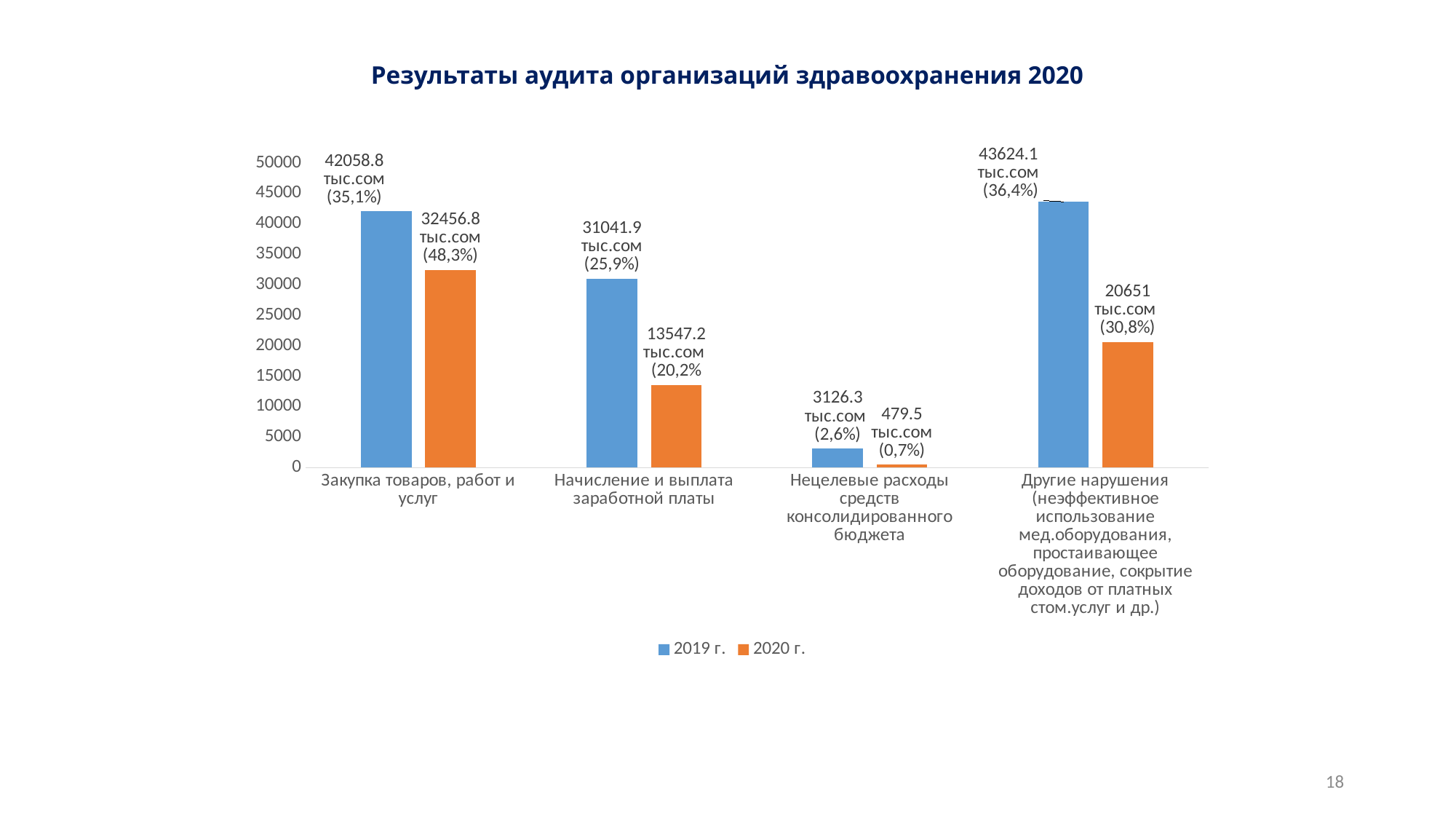
What is the 2019 г. value for Закупка товаров, работ и услуг? 42058.8 тыс.сом What type of chart is shown on the slide? bar chart What is the title of the chart? Результаты аудита организаций здравоохранения 2020 What is the difference between the 2019 г. and 2020 г. values for Другие нарушения? 22973.1 тыс.сом How many series does the legend list? 2 Which is larger for Начисление и выплата заработной платы: the 2019 г. value or the 2020 г. value? 2019 г. How many categories are shown on the x axis? 4 Which category has the lowest 2019 г. value? Нецелевые расходы средств консолидированного бюджета What is the 2020 г. value for Нецелевые расходы средств консолидированного бюджета? 479.5 тыс.сом Which category has the highest 2020 г. value? Закупка товаров, работ и услуг What is the 2020 г. value for Начисление и выплата заработной платы? 13547.2 тыс.сом What percentage is shown for the 2019 г. bar of Другие нарушения? 36,4%